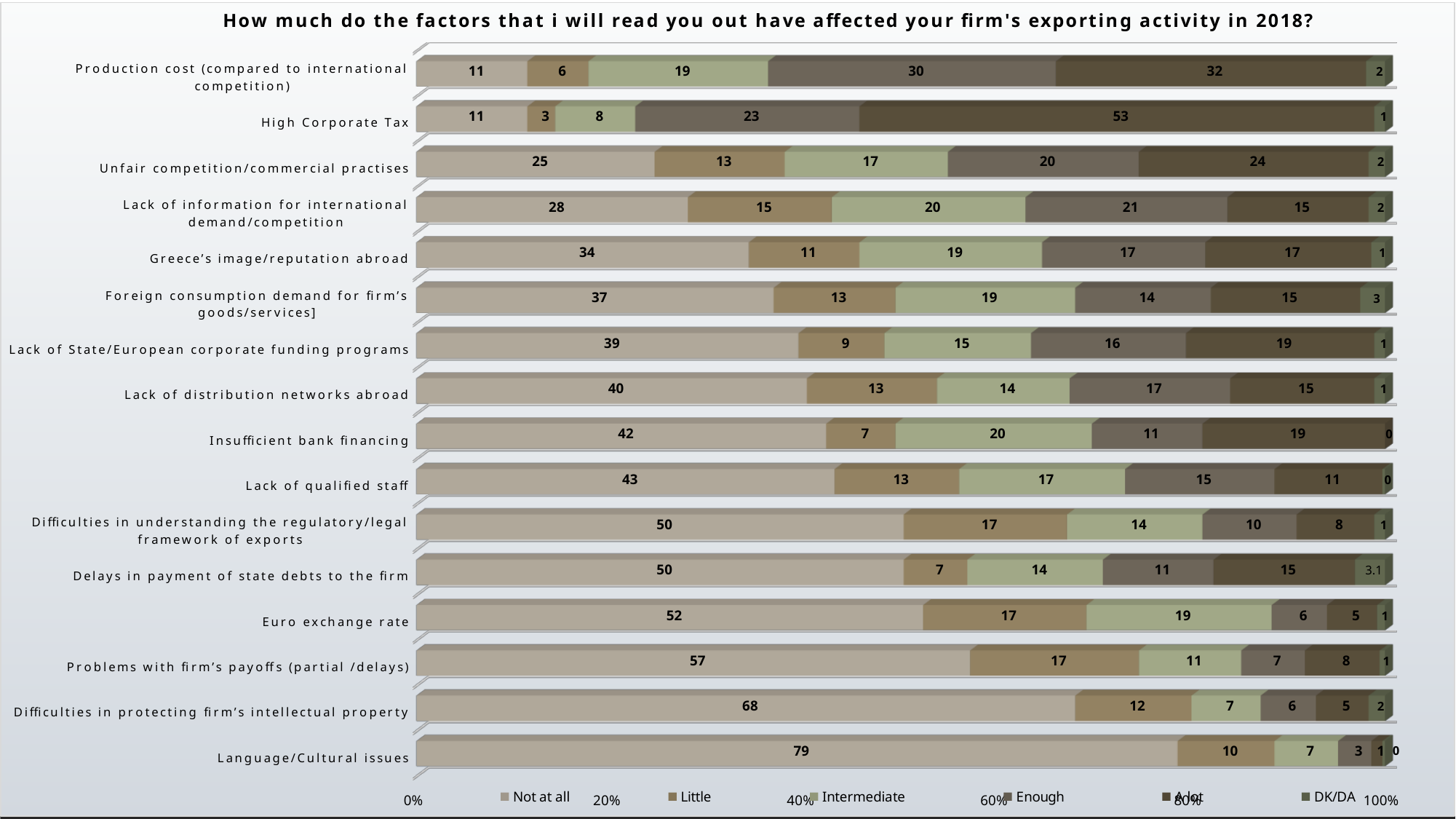
How many series does the legend list? 6 What is the 'A lot' value for High Corporate Tax? 53 What is the 'Not at all' value for Language/Cultural issues? 79 What is the 'Enough' value for Production cost (compared to international competition)? 30 What is the 'Intermediate' value for Insufficient bank financing? 20 What is the total of the stacked bar for Production cost (compared to international competition)? 100 How many factors (categories) are shown in the chart? 16 Which factor has the highest 'Not at all' value? Language/Cultural issues Which factor has the highest 'A lot' value? High Corporate Tax What is the difference between the 'A lot' values for High Corporate Tax and Production cost (compared to international competition)? 21 What kind of chart is shown on the slide? Stacked bar chart Which has a larger 'Not at all' value: Euro exchange rate or Lack of qualified staff? Euro exchange rate